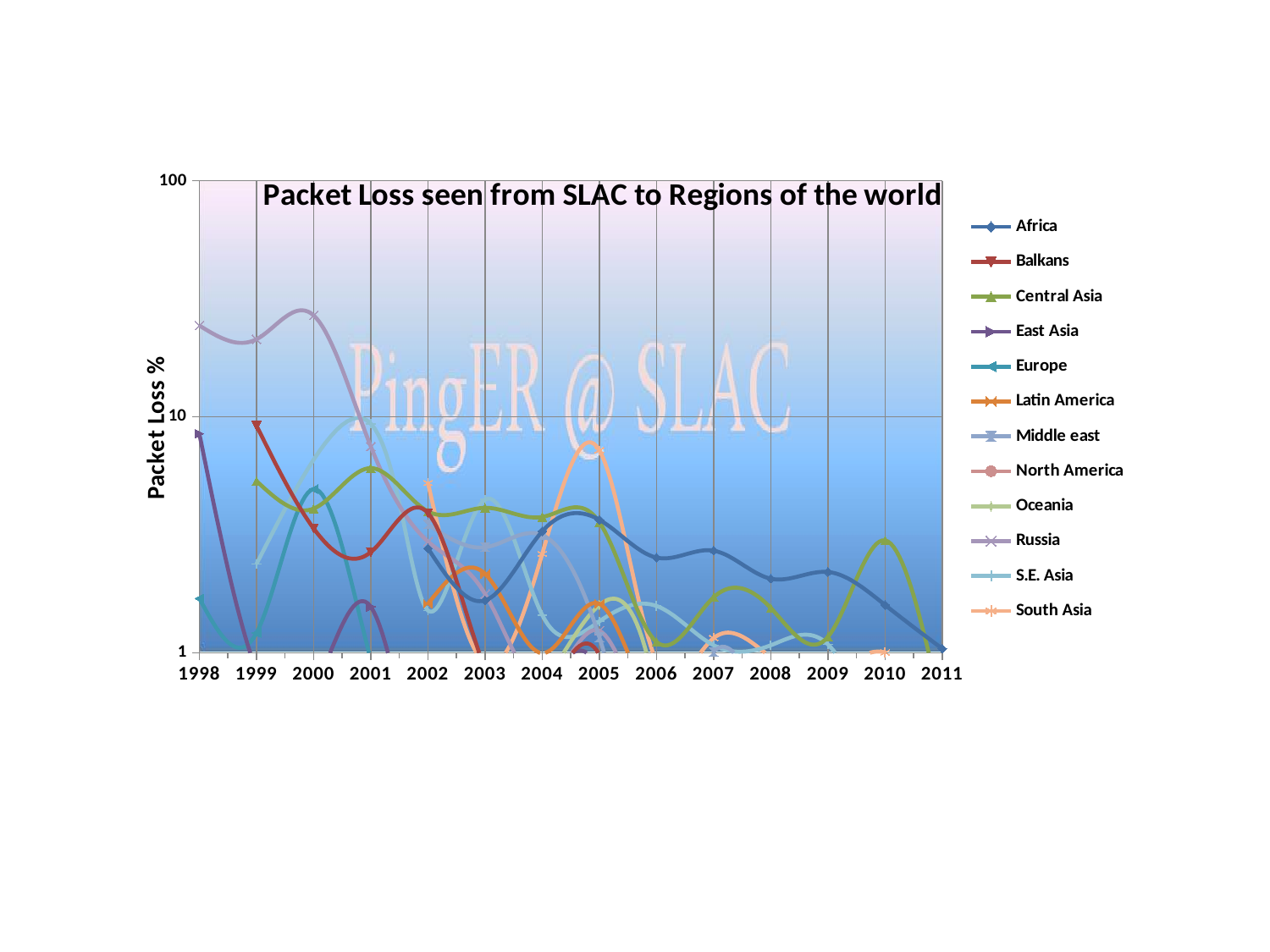
Is the packet loss for Africa in 2006 greater or less than 10? less What kind of chart is shown on the slide? line chart How many years are labelled on the x axis? 14 Is the packet loss for Russia in 1998 greater or less than 10? greater Does the packet loss for Russia rise or fall from 2000 to 2003? fall Is the packet loss for Central Asia in 2010 greater or less than 10? less What is the label of the y axis? Packet Loss % How many series does the legend list? 12 Which is larger in 1998, the packet loss for Russia or for East Asia? Russia Which region has the highest packet loss in 1998? Russia What is the title of the chart? Packet Loss seen from SLAC to Regions of the world